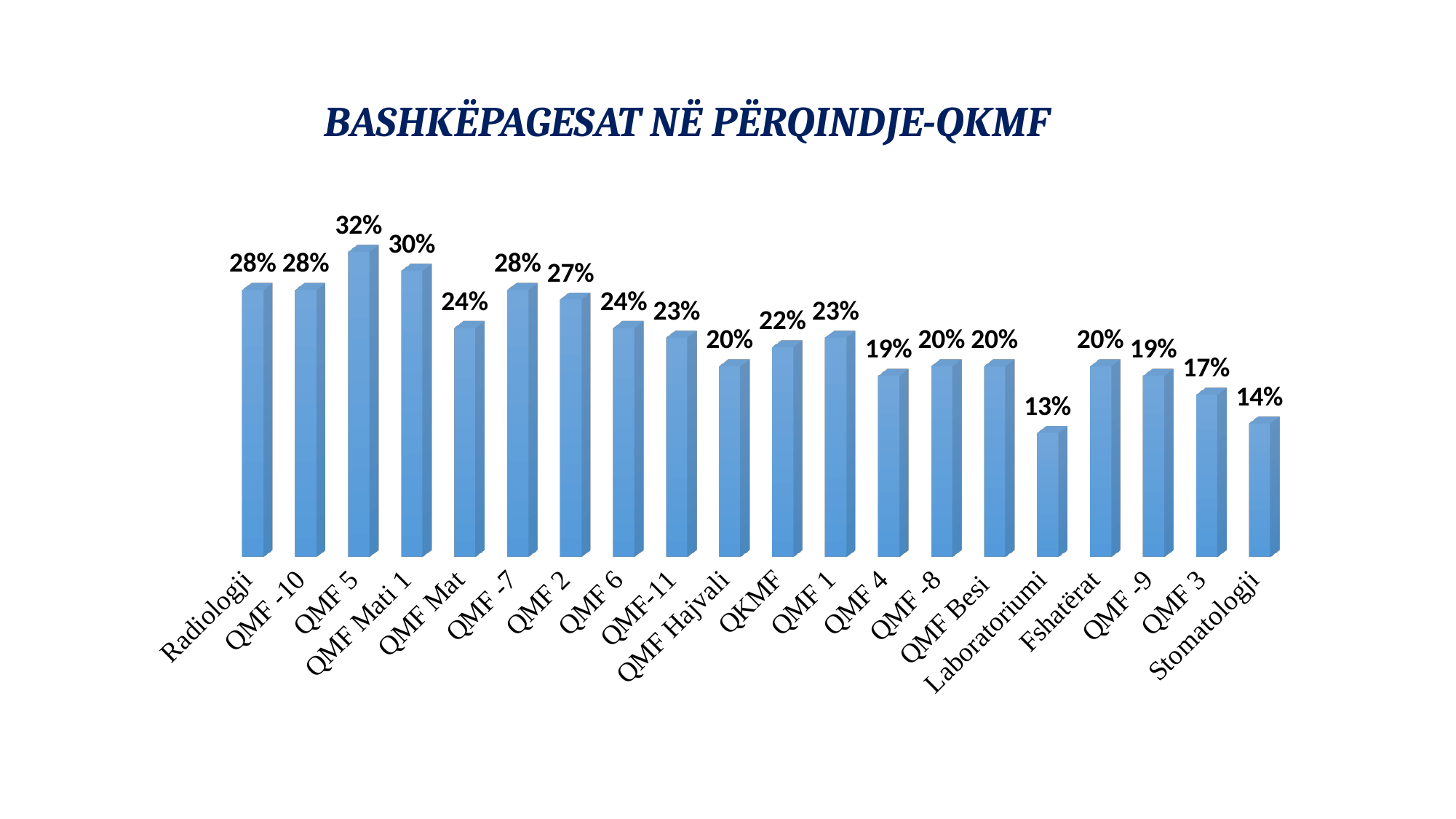
What is the value for QMF 5? 32% What is the value for Stomatologji? 14% Which is larger, the value for QMF 2 or the value for QKMF? QMF 2 Which category has the lowest value? Laboratoriumi What kind of chart is shown on the slide? Bar chart What is the difference between the values for QMF 5 and Laboratoriumi? 19% What is the value for Laboratoriumi? 13% What is the title of the chart? BASHKËPAGESAT NË PËRQINDJE-QKMF How many categories are shown in the chart? 20 What is the value for QMF Hajvali? 20% What is the difference between the values for QMF Mati 1 and QMF 3? 13% Which category has the highest value? QMF 5